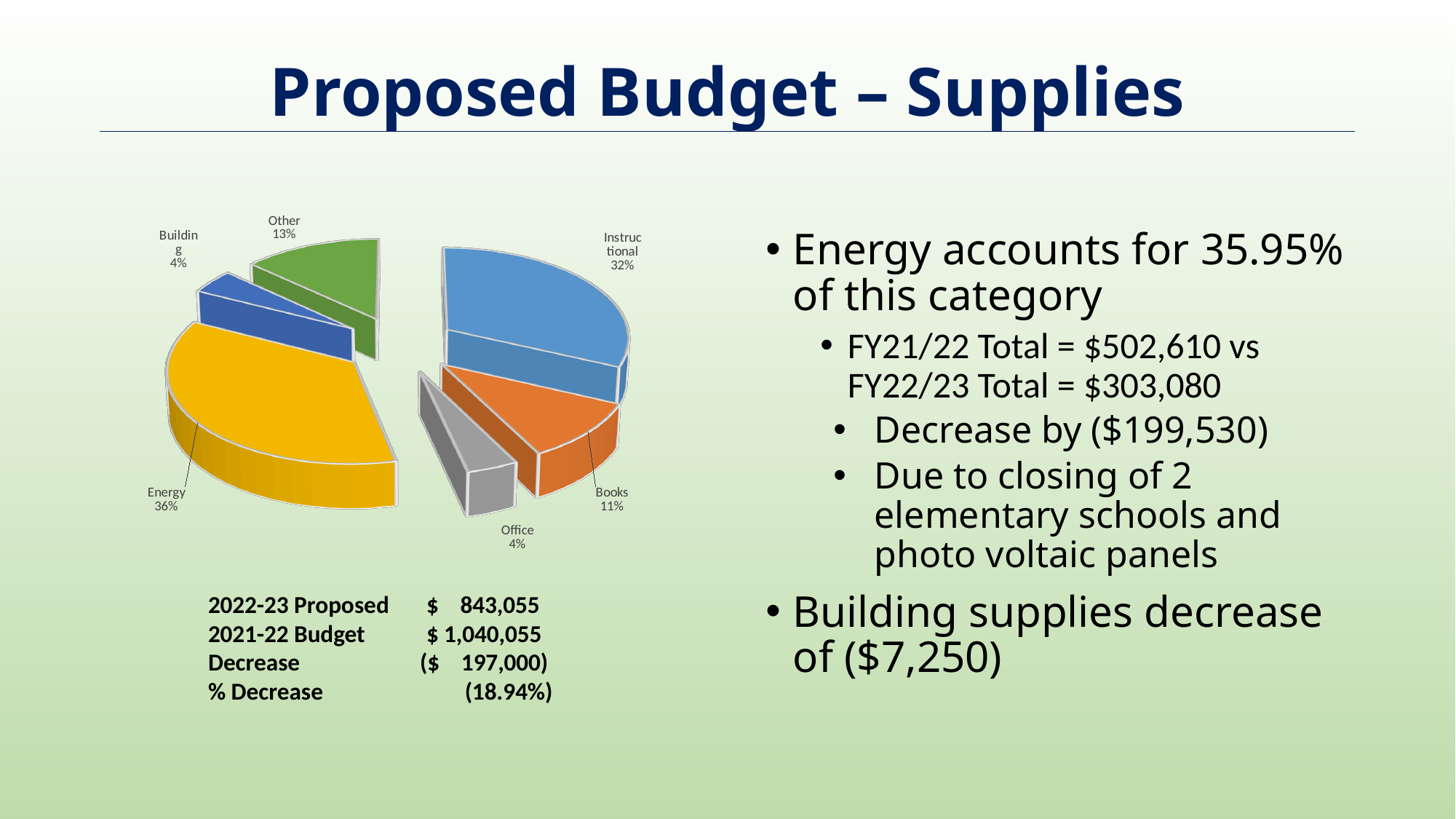
What colour is the Energy slice in the pie chart? yellow What percentage is shown for Other? 13% Which slice of the pie chart is the largest? Energy What kind of chart is shown on the slide? pie chart What is the difference in percentage points between the Other slice and the Office slice? 9 How many slices does the pie chart have? 6 What share of the pie does Instructional account for? 32% What percentage is shown for Books? 11% Which is larger, the Other slice or the Books slice? Other What percentage is shown for Office? 4% What is the difference in percentage points between the Energy slice and the Instructional slice? 4 What share of the pie does Energy account for? 36%